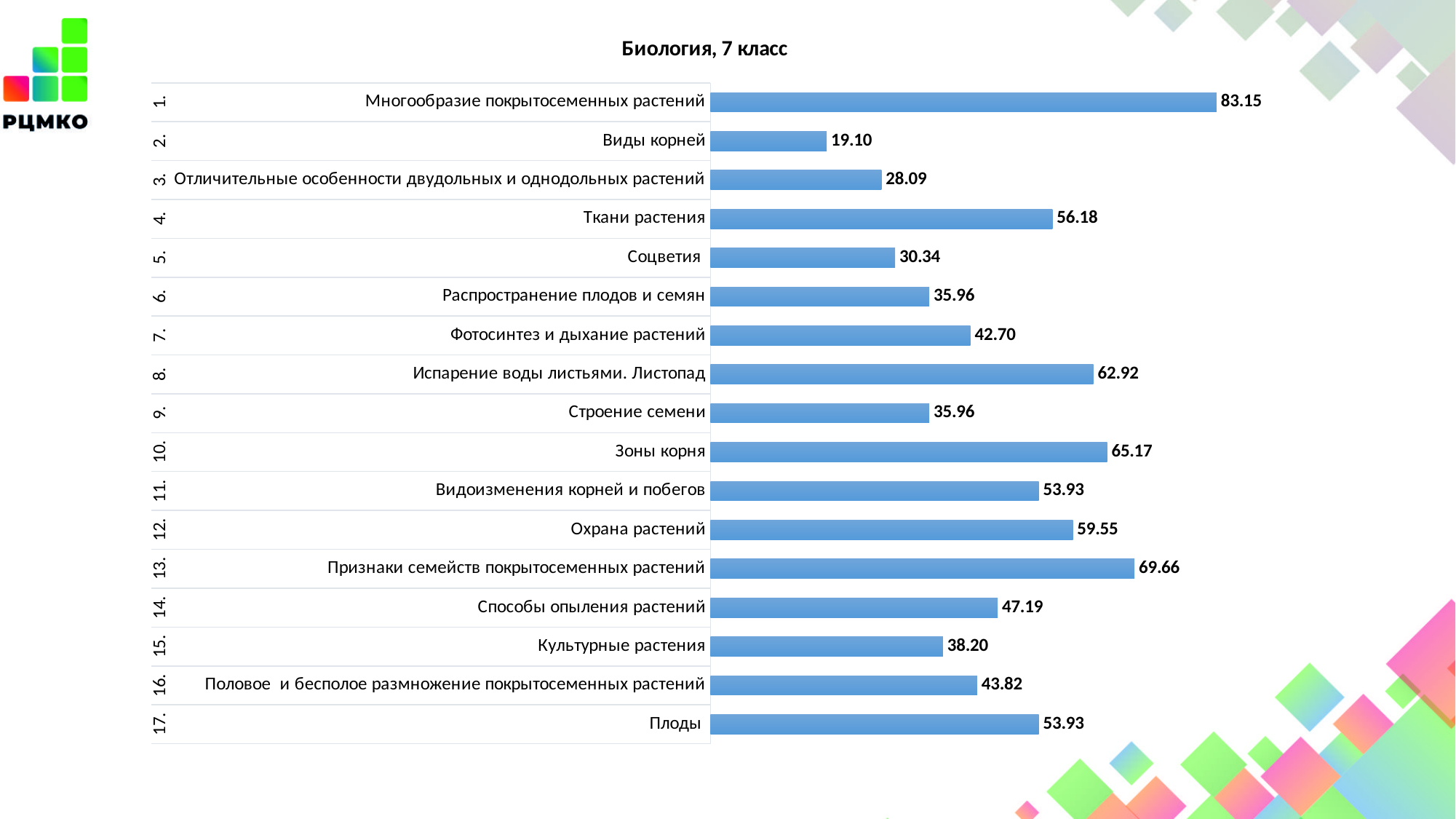
What is the difference between the values for "Признаки семейств покрытосеменных растений" and "Зоны корня"? 4.49 Which is larger, the value for "Охрана растений" or the value for "Ткани растения"? Охрана растений What kind of chart is shown on the slide? Bar chart What is the value for "Фотосинтез и дыхание растений"? 42.70 What is the value for "Зоны корня"? 65.17 What is the value for "Культурные растения"? 38.20 What is the difference between the values for "Многообразие покрытосеменных растений" and "Виды корней"? 64.05 Which category has the lowest value? Виды корней What is the title of the chart? Биология, 7 класс Which category has the highest value? Многообразие покрытосеменных растений What is the value for "Испарение воды листьями. Листопад"? 62.92 How many categories are shown in the chart? 17